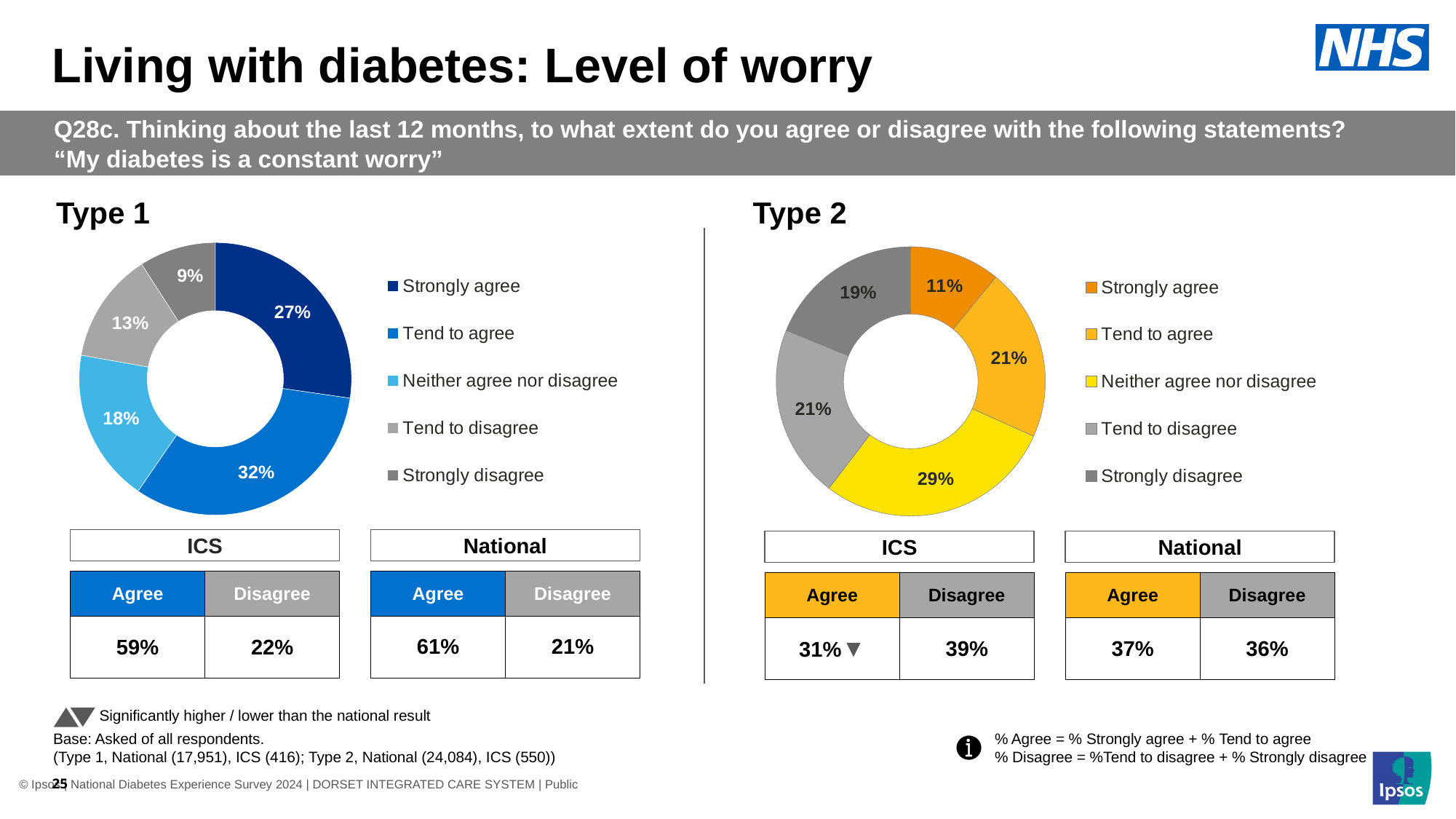
In the Type 1 chart, what percentage of respondents said they strongly agree? 27% How many response categories does the legend of the Type 2 chart list? 5 In the Type 2 chart, what percentage of respondents said they strongly disagree? 19% In the Type 2 chart, which response category has the smallest share? Strongly agree In the Type 2 chart, is the share for Strongly agree larger or smaller than the share for Strongly disagree? Smaller What type of chart is used to show the Type 1 results? Doughnut (pie) chart In the Type 1 chart, which response category has the largest share? Tend to agree In the Type 1 chart, what is the difference in percentage points between Tend to agree and Strongly agree? 5 In the Type 2 chart, what percentage of respondents said they neither agree nor disagree? 29% In the Type 2 chart, which response category has the largest share? Neither agree nor disagree In the Type 1 chart, which response category has the smallest share? Strongly disagree In the Type 1 chart, what percentage of respondents said they tend to agree? 32%